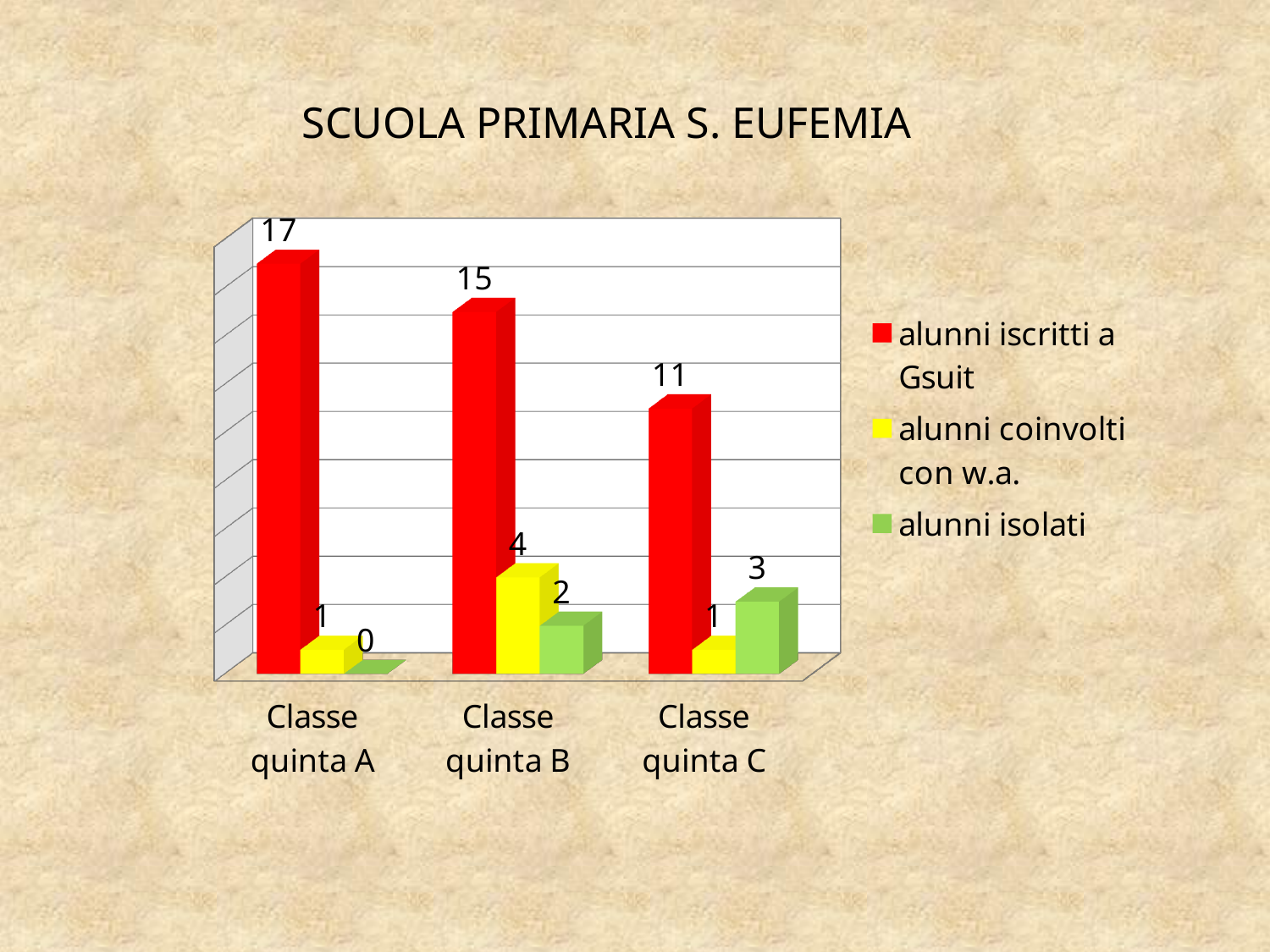
How many series does the legend list? 3 What is the value for 'alunni coinvolti con w.a.' in Classe quinta B? 4 Which class has the lowest value for 'alunni iscritti a Gsuit'? Classe quinta C What kind of chart is shown on the slide? bar chart Which class has the highest value for 'alunni iscritti a Gsuit'? Classe quinta A How many classes are shown on the x axis? 3 What is the difference between 'alunni iscritti a Gsuit' in Classe quinta A and Classe quinta C? 6 What is the value for 'alunni isolati' in Classe quinta A? 0 What is the value for 'alunni isolati' in Classe quinta C? 3 What is the value for 'alunni iscritti a Gsuit' in Classe quinta A? 17 Do the values for 'alunni iscritti a Gsuit' rise or fall from Classe quinta A to Classe quinta C? fall Which is larger: 'alunni coinvolti con w.a.' in Classe quinta B or 'alunni isolati' in Classe quinta B? alunni coinvolti con w.a.